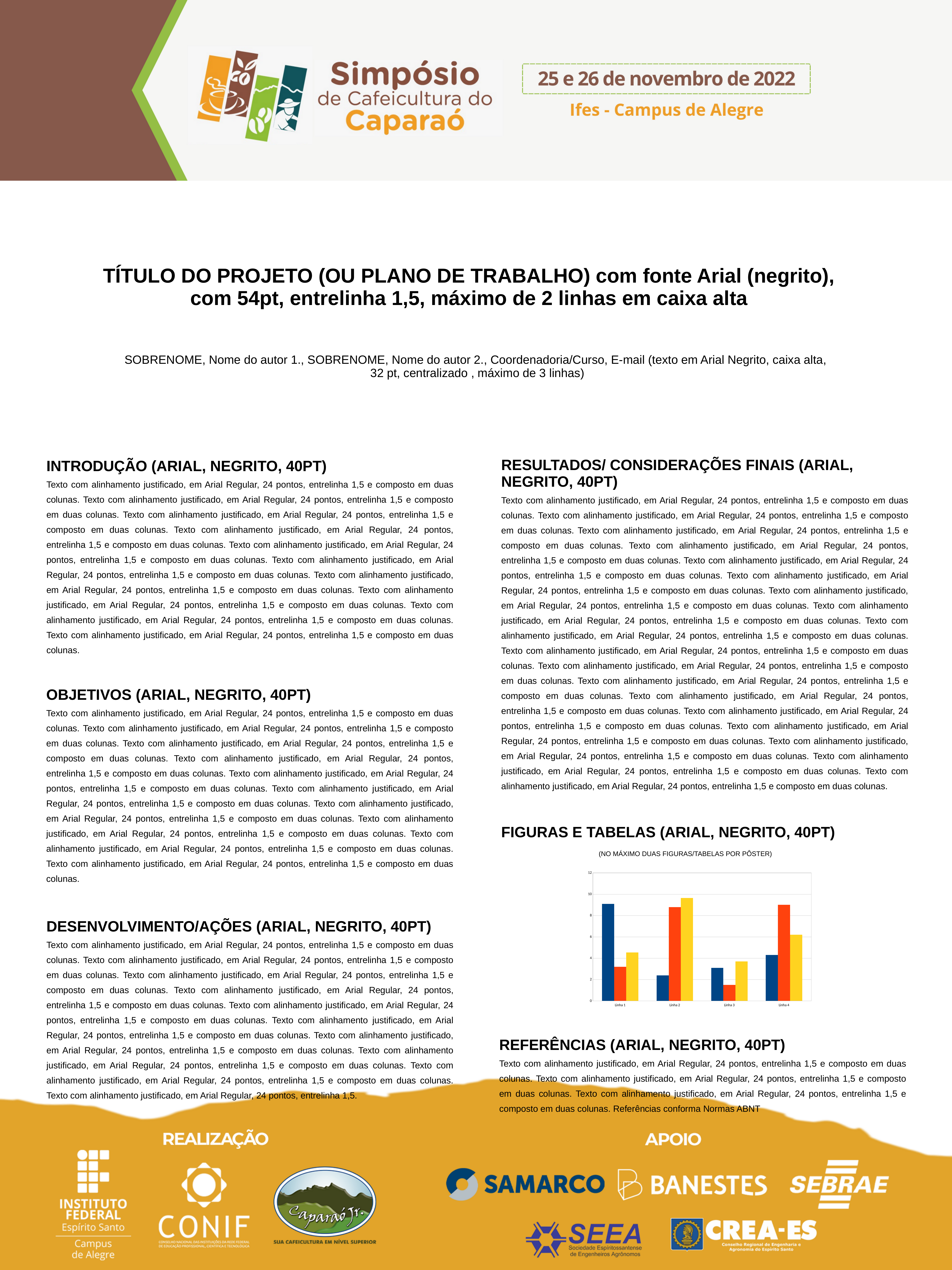
Is the value of the blue bar for Linha 2 greater or less than 4? less What is the highest value shown on the y axis of the bar chart? 12 How many categories are shown on the x axis of the bar chart? 4 Is the value of the red bar for Linha 3 greater or less than 2? less Is the value of the yellow bar for Linha 2 greater or less than 8? greater What kind of chart is shown under the heading FIGURAS E TABELAS? bar chart Which category has the tallest blue bar in the bar chart? Linha 1 Which category has the shortest yellow bar in the bar chart? Linha 3 What is the label of the first category on the x axis of the bar chart? Linha 1 For Linha 4, which bar is taller: the red bar or the yellow bar? red Which category has the shortest red bar in the bar chart? Linha 3